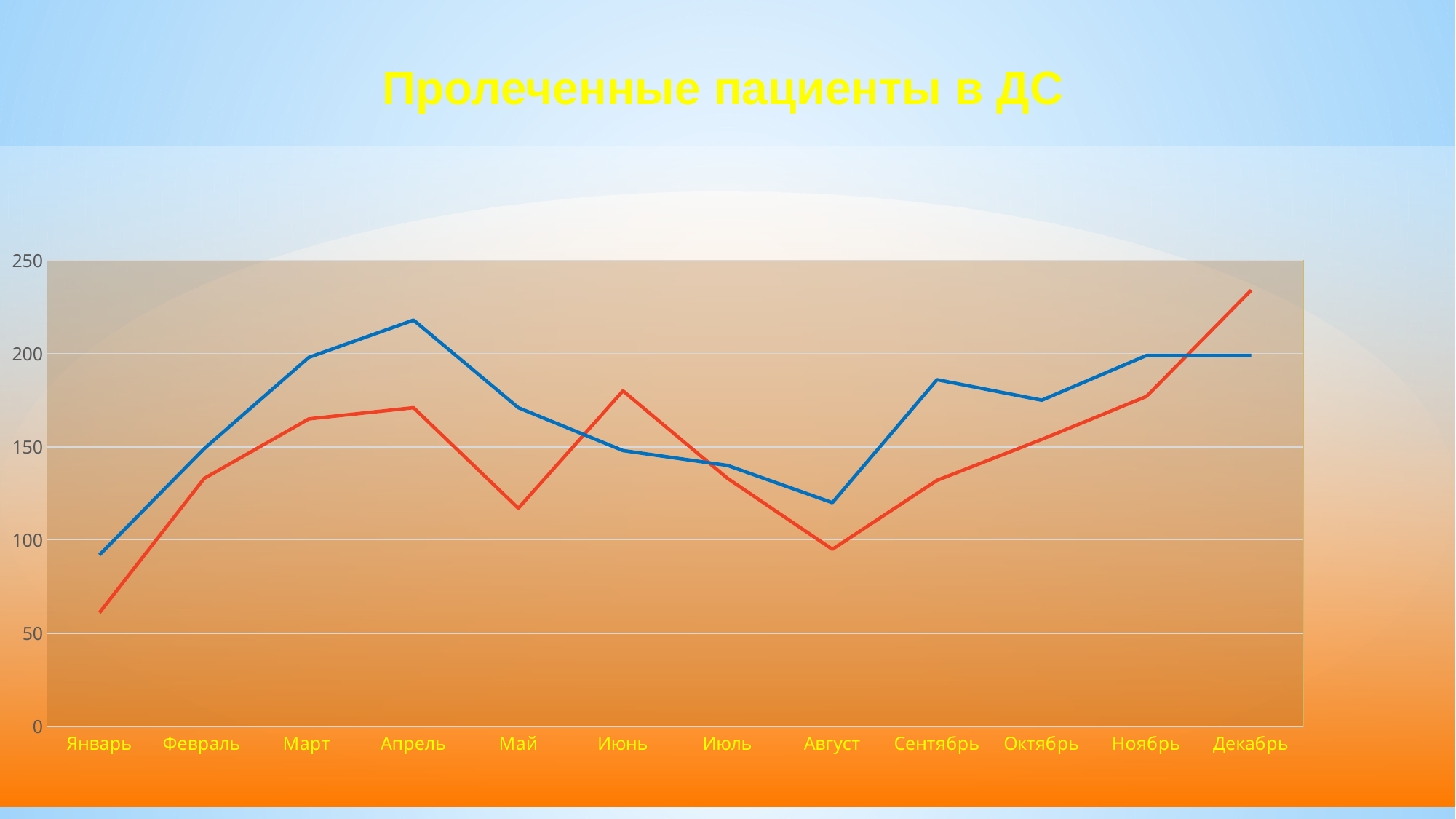
In Январь, which line is higher, the blue line or the red line? the blue line Is the value of the blue line for Апрель greater or less than 200? greater Is the value of the red line for Январь greater or less than 100? less How many lines are plotted on the chart? 2 In which month does the blue line reach its highest value? Апрель Is the value of the blue line for Январь greater or less than 100? less What is the title of the chart? Пролеченные пациенты в ДС What kind of chart is shown on the slide? line chart In which month is the red line at its lowest value? Январь How many months are shown along the x axis? 12 In which month does the red line reach its highest value? Декабрь